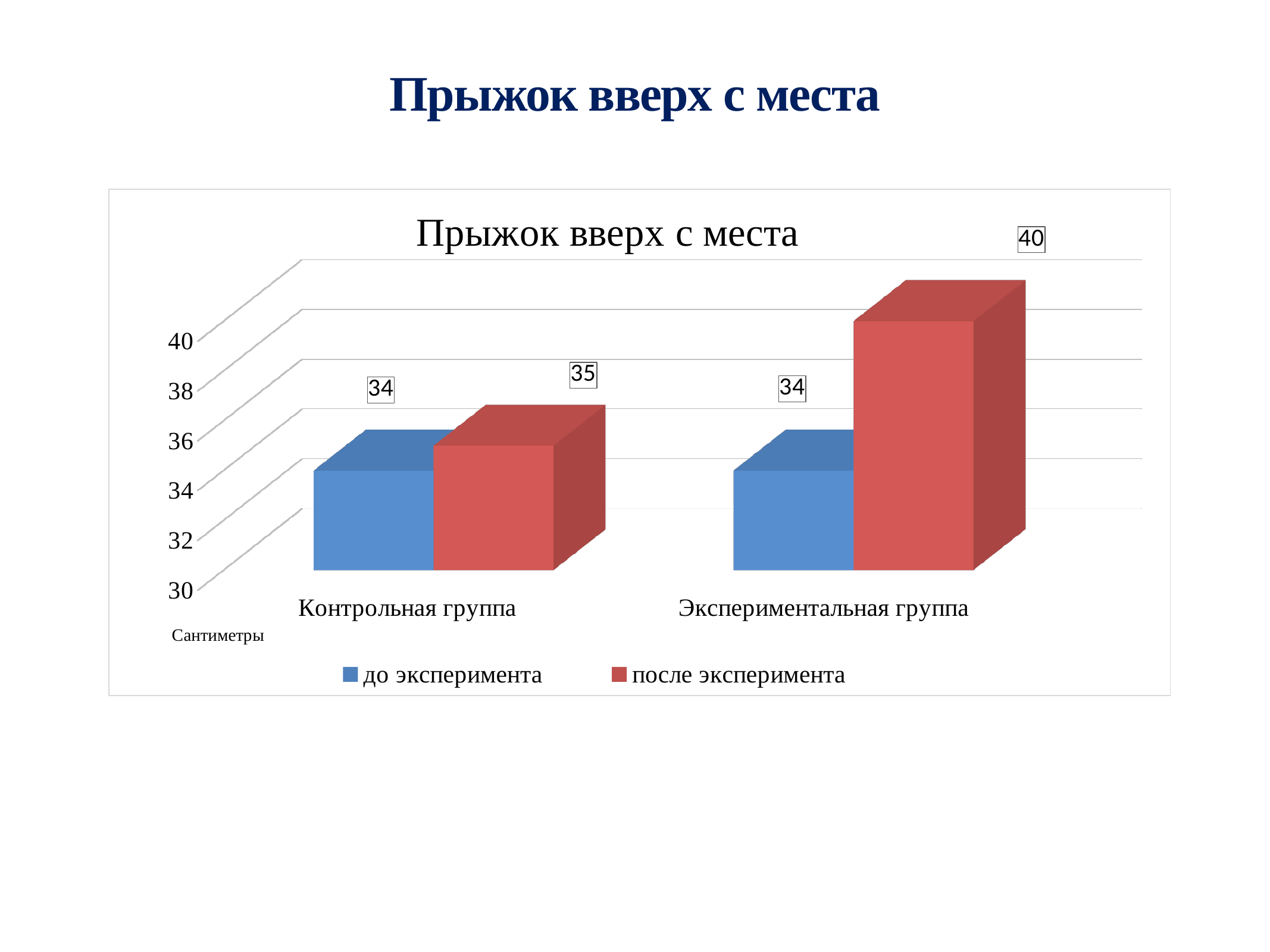
What is the difference between the 'после эксперимента' values for 'Экспериментальная группа' and 'Контрольная группа'? 5 What kind of chart is shown on the slide? Bar chart Which category has the highest 'после эксперимента' value? Экспериментальная группа What is the title of the chart? Прыжок вверх с места What is the value for 'после эксперимента' in the 'Контрольная группа' category? 35 How many series does the legend list? 2 What is the value for 'до эксперимента' in the 'Контрольная группа' category? 34 What is the value for 'до эксперимента' in the 'Экспериментальная группа' category? 34 What is the difference between the 'после эксперимента' and 'до эксперимента' values for 'Экспериментальная группа'? 6 What is the value for 'после эксперимента' in the 'Экспериментальная группа' category? 40 Which is larger: the 'после эксперимента' value for 'Контрольная группа' or for 'Экспериментальная группа'? Экспериментальная группа How many categories are shown on the x axis? 2